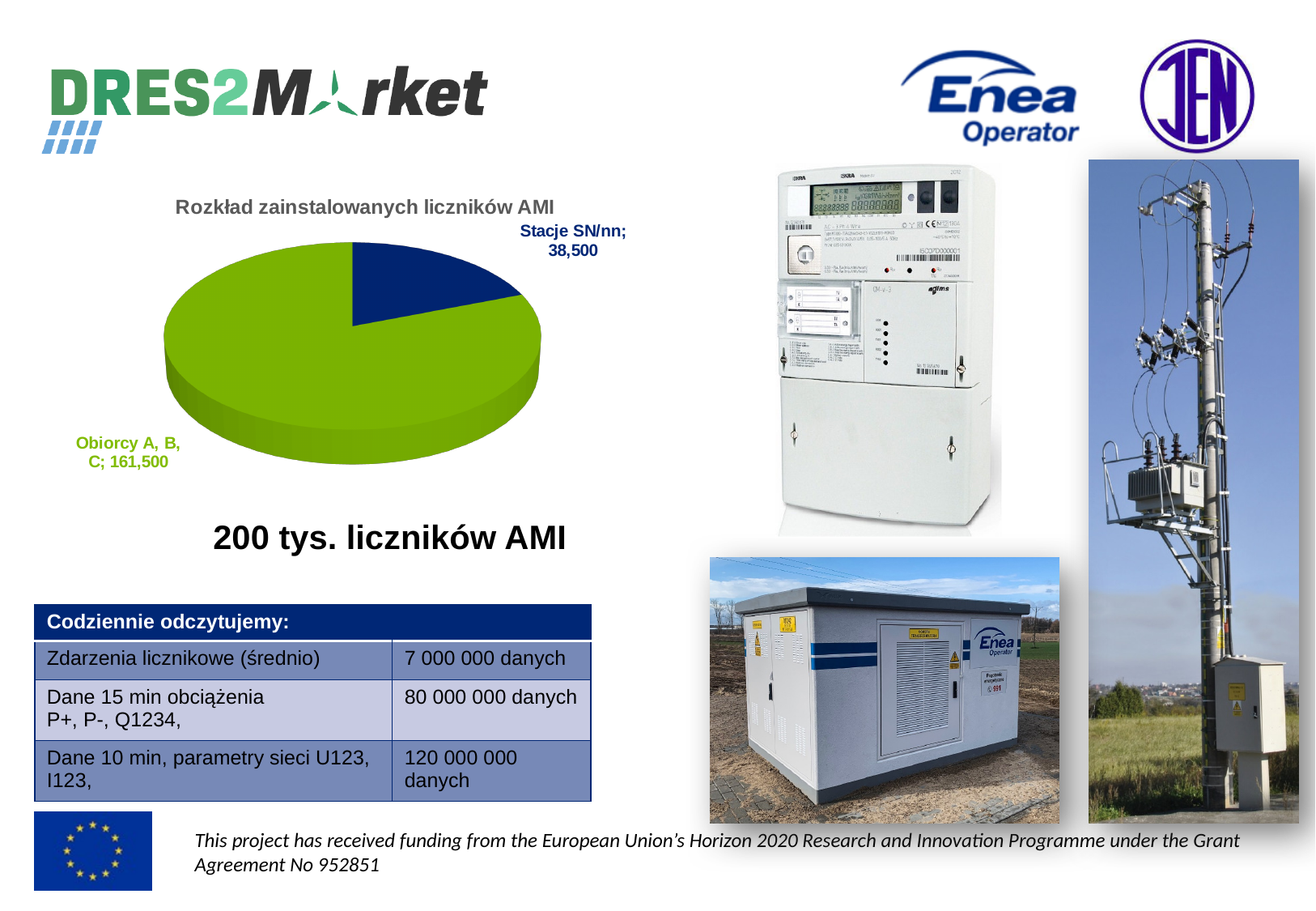
Which slice of the pie chart is the largest? Obiorcy A, B, C What is the value for Stacje SN/nn in the pie chart? 38,500 What is the difference between the values for Obiorcy A, B, C and Stacje SN/nn? 123,000 What is the value for Obiorcy A, B, C in the pie chart? 161,500 How many slices does the pie chart have? 2 What is the title of the pie chart? Rozkład zainstalowanych liczników AMI What share of the pie does Obiorcy A, B, C represent? 80.75% Which is larger in the pie chart: Stacje SN/nn or Obiorcy A, B, C? Obiorcy A, B, C What colour is the Stacje SN/nn slice in the pie chart? dark blue Which slice of the pie chart is the smallest? Stacje SN/nn What kind of chart is shown on the slide? pie chart What is the total of the two slices in the pie chart? 200,000